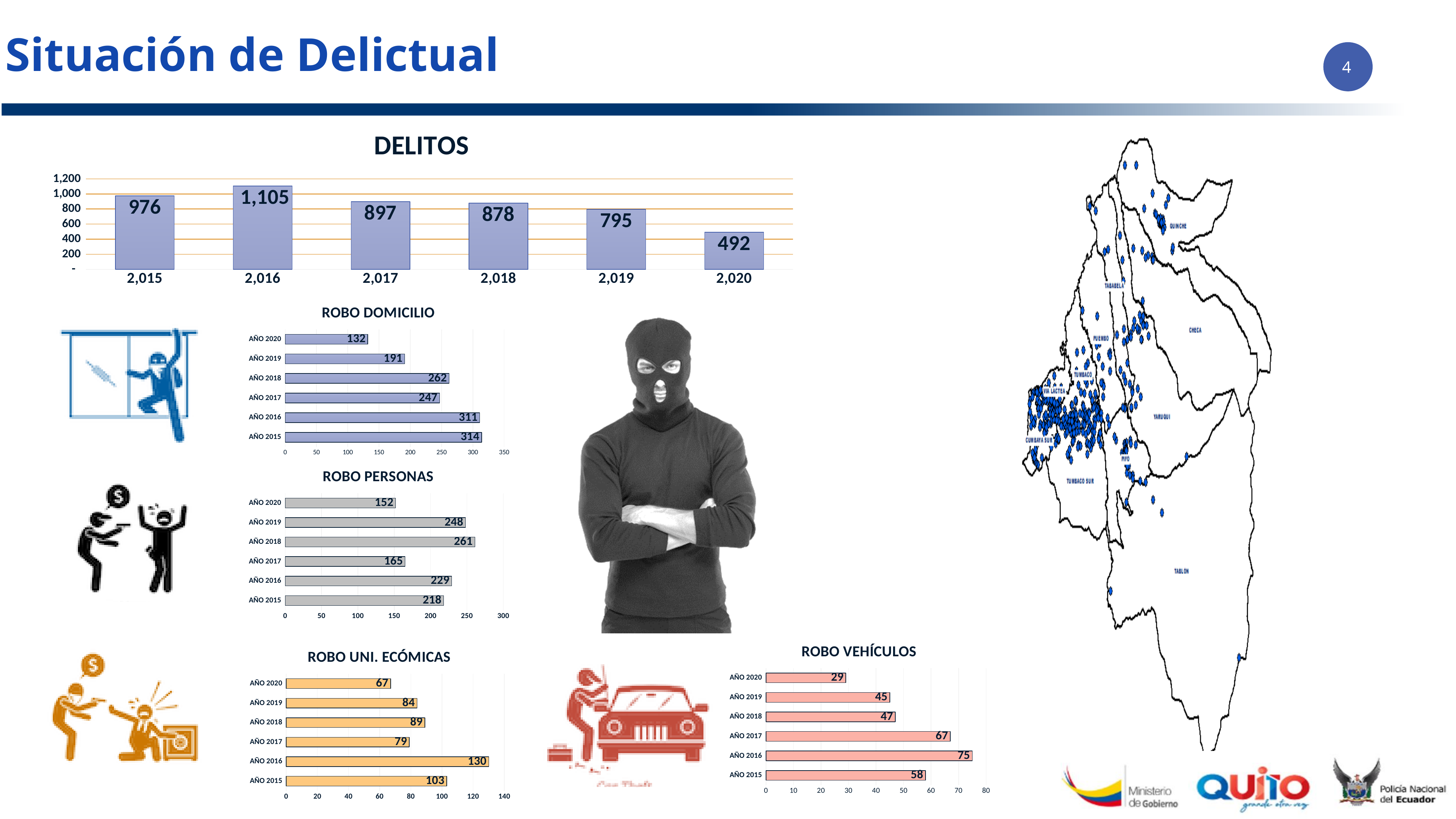
In the ROBO PERSONAS chart, what is the value for AÑO 2020? 152 In the DELITOS chart, what is the difference between the values for 2,015 and 2,020? 484 In the ROBO PERSONAS chart, which is larger, the value for AÑO 2017 or AÑO 2019? AÑO 2019 In the ROBO UNI. ECÓMICAS chart, which year has the highest value? AÑO 2016 How many years are shown in the ROBO VEHÍCULOS chart? 6 In the ROBO DOMICILIO chart, which year has the highest value? AÑO 2015 In the ROBO UNI. ECÓMICAS chart, what is the difference between the values for AÑO 2016 and AÑO 2020? 63 In the ROBO DOMICILIO chart, what is the value for AÑO 2018? 262 In the DELITOS chart, which year has the lowest value? 2,020 What kind of chart is the DELITOS chart? Bar chart In the DELITOS chart, what is the value for 2,016? 1,105 In the ROBO VEHÍCULOS chart, what is the value for AÑO 2016? 75